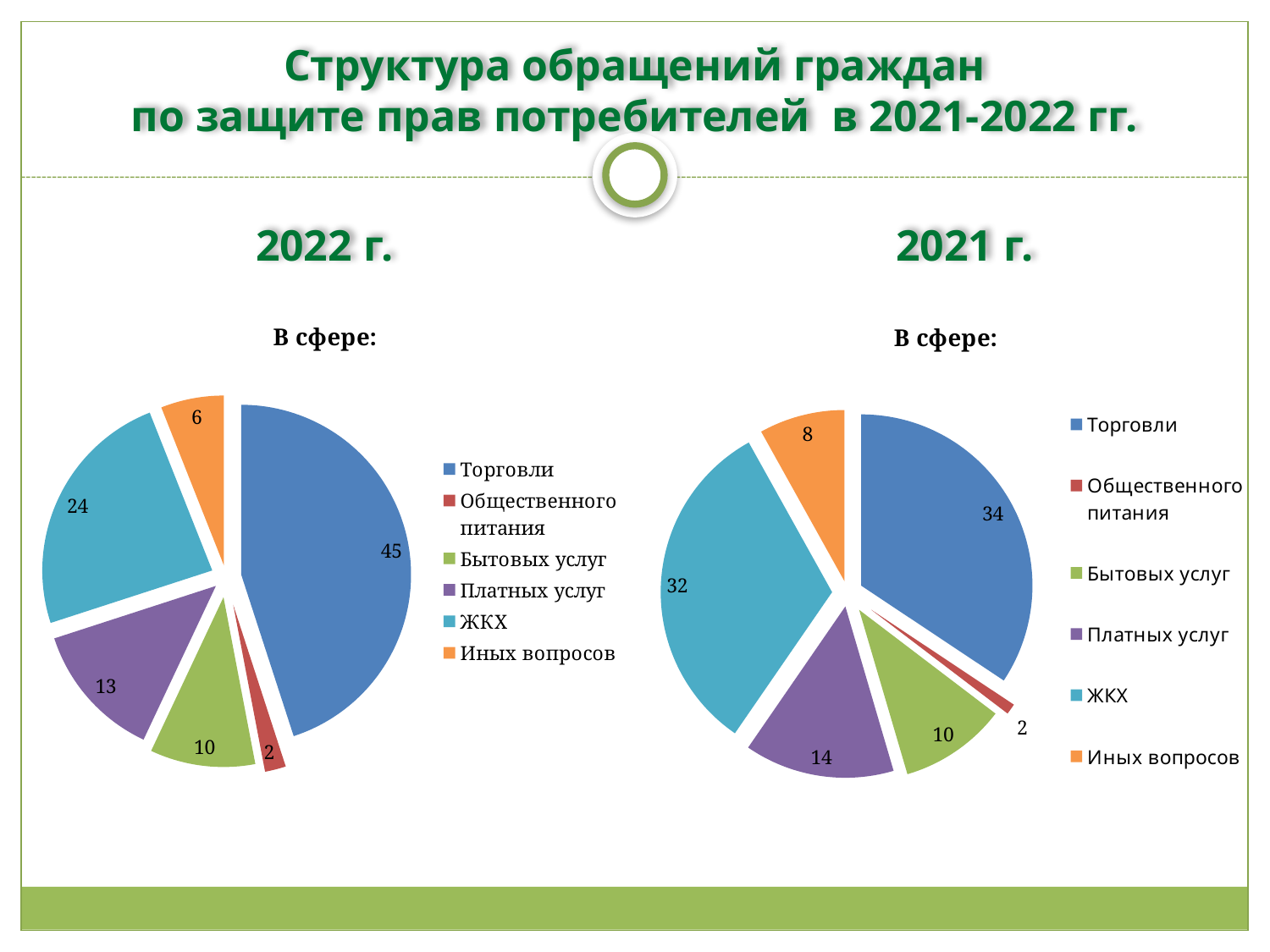
In the 2022 г. pie chart, what is the value for Иных вопросов? 6 In the 2021 г. pie chart, which colour represents ЖКХ? Teal (light blue) What type of chart is used for the 2021 г. data? Pie chart In the 2022 г. pie chart, which category has the largest slice? Торговли How many categories does the 2022 г. pie chart show? 6 In the 2021 г. pie chart, what is the value for ЖКХ? 32 In the 2021 г. pie chart, what is the difference between the values for Платных услуг and Бытовых услуг? 4 In the 2021 г. pie chart, which is larger: Торговли or ЖКХ? Торговли In the 2022 г. pie chart, what is the value for Торговли? 45 In the 2022 г. pie chart, what share of the total does Торговли represent? 45% In the 2022 г. pie chart, what is the difference between the values for ЖКХ and Платных услуг? 11 In the 2021 г. pie chart, which category has the smallest slice? Общественного питания